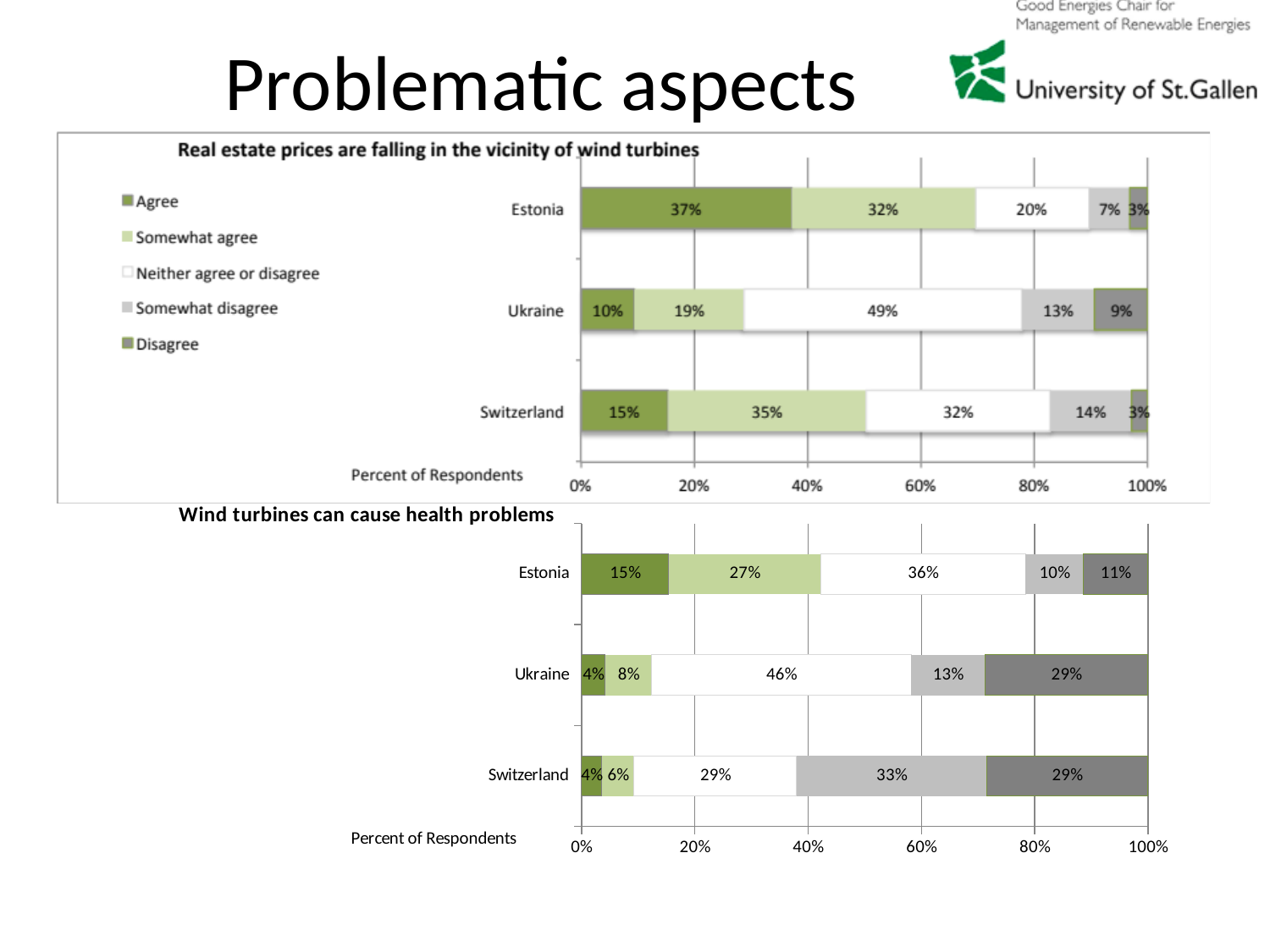
In the chart titled 'Real estate prices are falling in the vicinity of wind turbines', which is larger: the 'Disagree' share for Ukraine or for Switzerland? Ukraine In the chart titled 'Real estate prices are falling in the vicinity of wind turbines', what is the difference between the 'Somewhat agree' shares for Switzerland and Ukraine? 16% In the chart titled 'Wind turbines can cause health problems', how many countries are shown? 3 In the chart titled 'Real estate prices are falling in the vicinity of wind turbines', what percentage of respondents in Estonia chose 'Agree'? 37% In the chart titled 'Wind turbines can cause health problems', what is the difference between the dark green first segments of Estonia and Ukraine? 11% What type of chart is the chart titled 'Wind turbines can cause health problems'? Stacked bar chart In the chart titled 'Wind turbines can cause health problems', what percentage is shown for the white middle segment of the Ukraine bar? 46% In the chart titled 'Real estate prices are falling in the vicinity of wind turbines', what percentage of respondents in Ukraine chose 'Neither agree or disagree'? 49% In the chart titled 'Real estate prices are falling in the vicinity of wind turbines', how many series does the legend list? 5 In the chart titled 'Wind turbines can cause health problems', what percentage is shown for the dark grey last segment of the Estonia bar? 11% In the chart titled 'Real estate prices are falling in the vicinity of wind turbines', which country has the highest 'Agree' share? Estonia In the chart titled 'Wind turbines can cause health problems', which country has the largest light grey segment? Switzerland